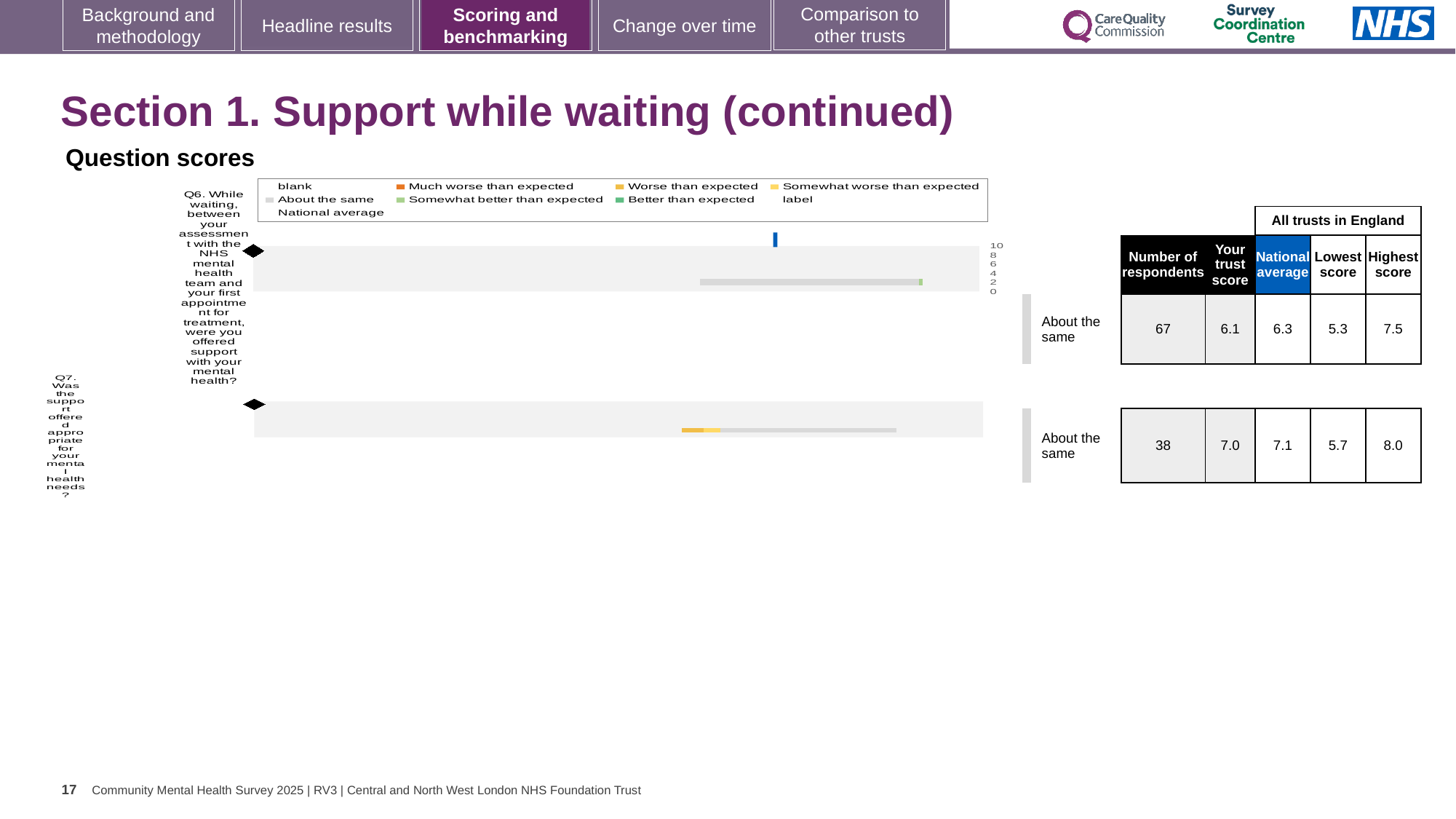
Which question has the higher trust score, Q6 or Q7? Q7 What is the difference between the highest score and the lowest score for Q7? 2.3 What kind of chart is used to show the question scores on this slide? bar chart What is the national average score for Q7 (was the support offered appropriate for your mental health needs)? 7.1 What is the difference between the national average and the trust score for Q6? 0.2 What is the 'Your trust score' for Q6 (support with your mental health while waiting)? 6.1 What is the highest score among all trusts in England for Q7? 8.0 How many respondents answered Q6? 67 For Q6, which is larger: the trust score or the national average? national average How many questions (bars) are plotted in the question scores chart? 2 What benchmark category is shown for Q6's trust score? About the same How many respondents answered Q7? 38